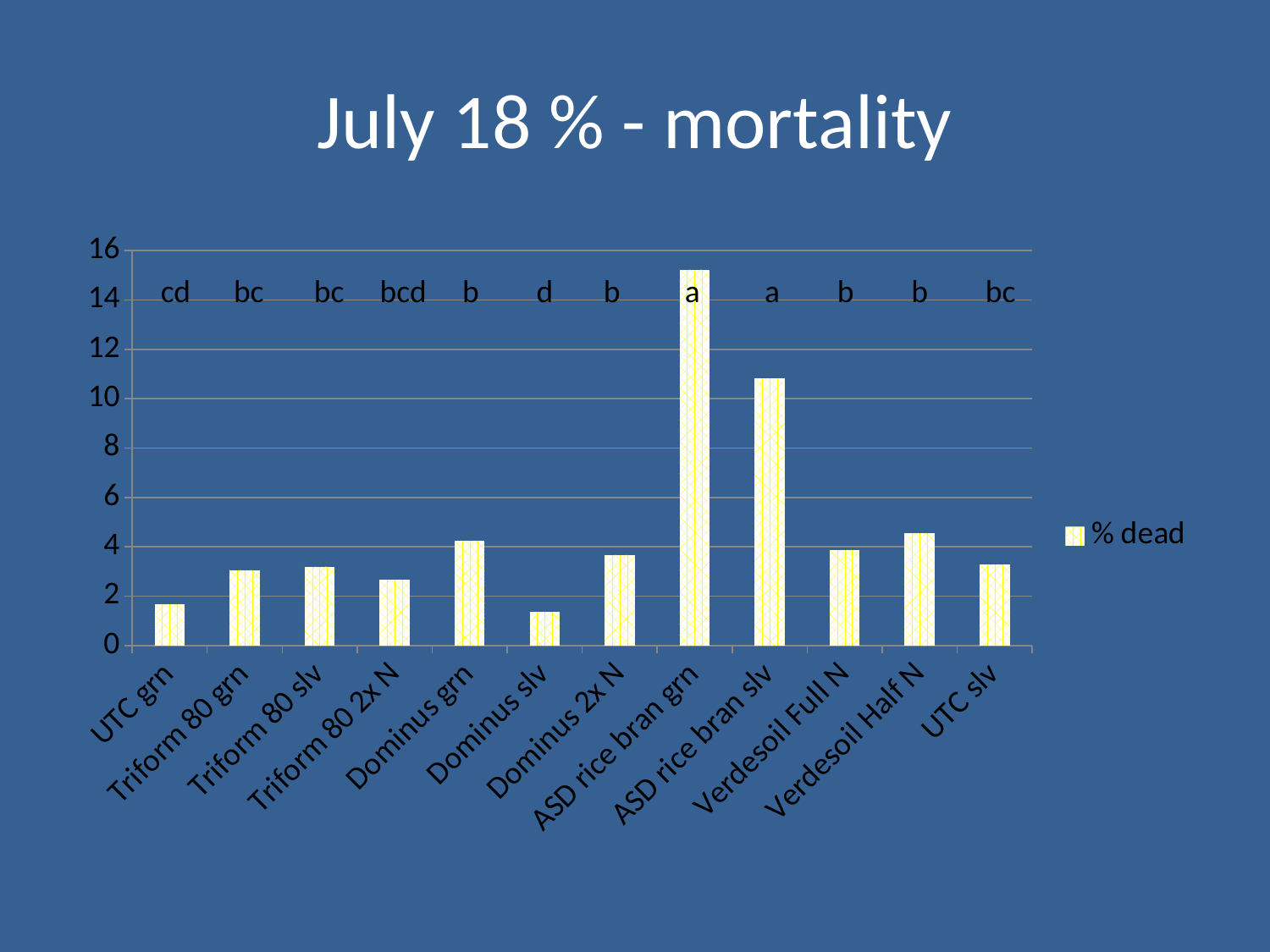
Which category has the highest % dead value? ASD rice bran grn Is the value for ASD rice bran slv greater or less than 10? greater Is the value for Triform 80 2x N greater or less than 4? less Which category has the lowest % dead value? Dominus slv What is the title of the chart? July 18 % - mortality Which has a larger value, Dominus grn or Dominus slv? Dominus grn Which has a larger value, ASD rice bran grn or ASD rice bran slv? ASD rice bran grn What kind of chart is shown on the slide? bar chart Is the value for ASD rice bran grn greater or less than 14? greater How many series does the legend list? 1 How many categories are shown on the x axis of the chart? 12